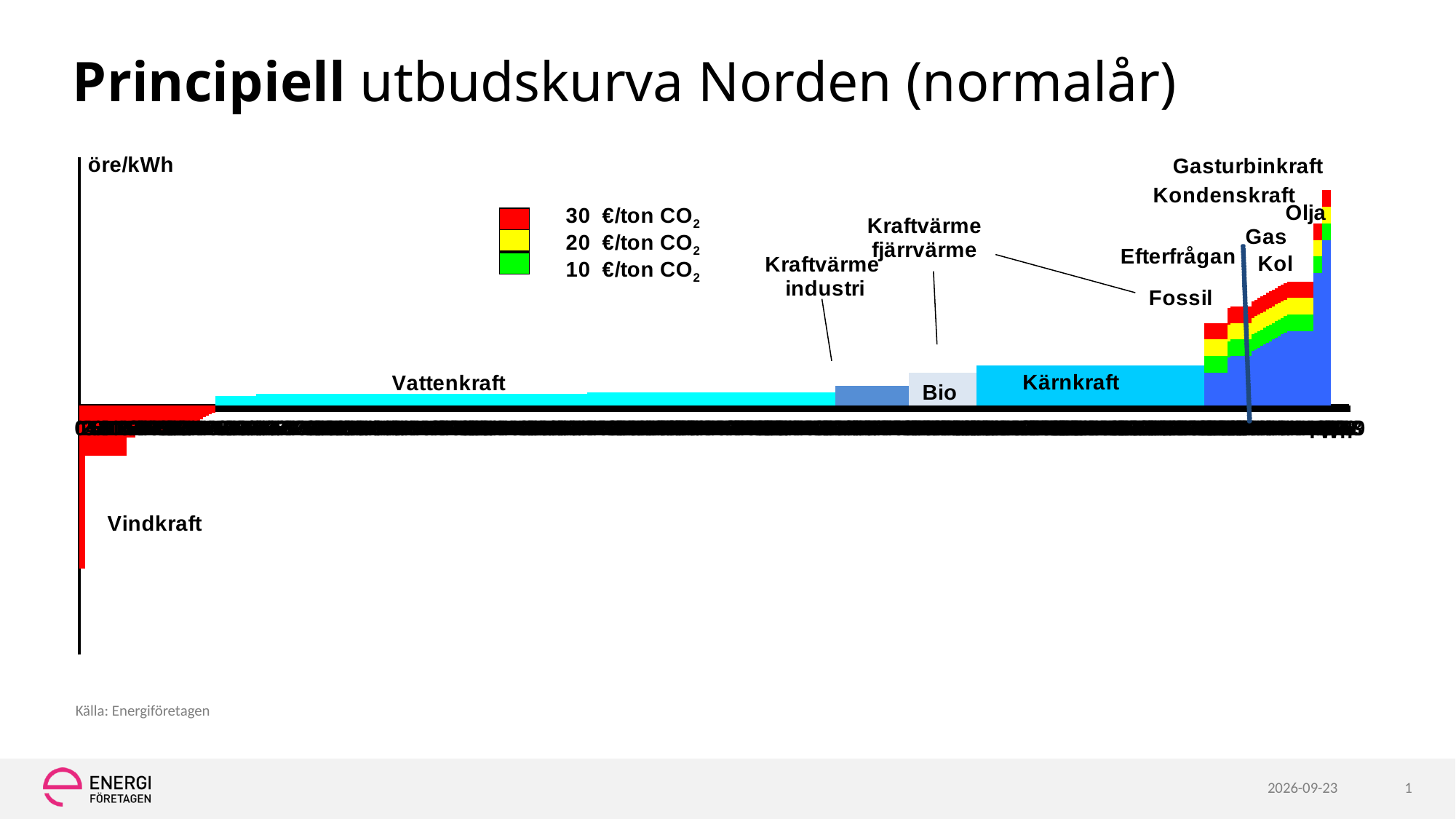
Is Kol plotted higher or lower on the curve than Olja? Lower Which is plotted higher on the curve, Fossil or Bio? Fossil Which technology is at the highest point of the supply curve? Gasturbinkraft How many CO2 price levels does the legend list? 3 What unit is shown on the vertical axis of the chart? öre/kWh Which technology is plotted below the horizontal axis, with a negative value? Vindkraft Is Bio plotted higher or lower on the curve than Kärnkraft? Lower Do the values of the supply curve rise or fall from left to right? Rise Which colour in the legend represents 30 €/ton CO2? Red